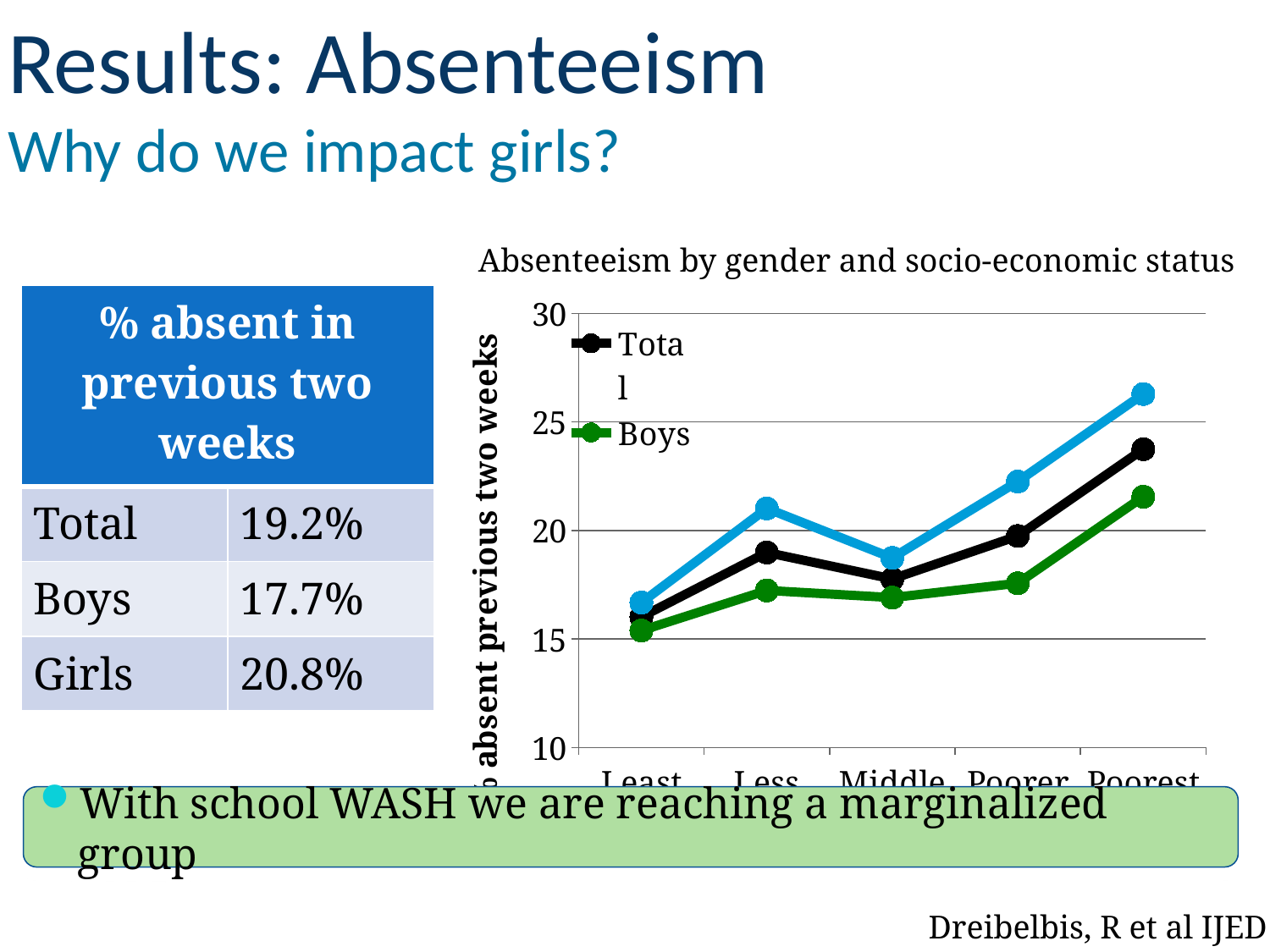
Is the value for Total at Poorest greater or less than 20? greater What is the title of the chart on the slide? Absenteeism by gender and socio-economic status Does the Total line rise or fall overall from Least to Poorest? rise Is the value for Boys at Poorest greater or less than 20? greater At which socio-economic category is the Total line highest? Poorest How many socio-economic categories are shown on the x axis of the chart? 5 Is the value for Boys at Least greater or less than 20? less What is the label of the y axis of the chart? % absent previous two weeks At which socio-economic category is the Boys line lowest? Least What kind of chart is 'Absenteeism by gender and socio-economic status'? line chart Which is larger at Poorest, the Total value or the Boys value? Total